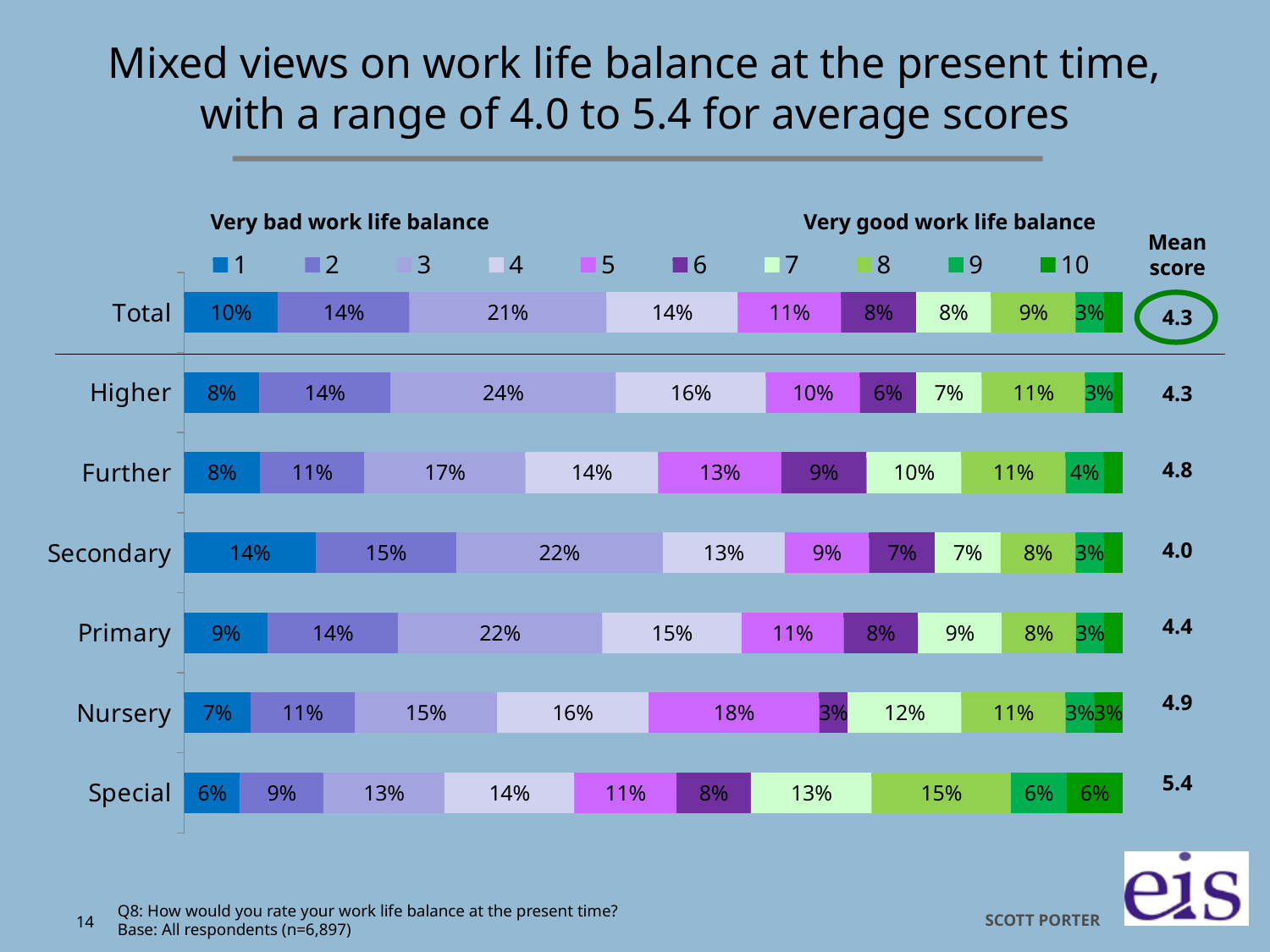
What is the mean score shown for the Special sector? 5.4 What kind of chart is shown on the slide? Stacked bar chart Which sector has the lowest percentage giving a rating of 1? Special What percentage of Special respondents gave a rating of 8? 15% What is the difference in percentage points between Nursery and Secondary for a rating of 5? 9 percentage points How many rating categories does the legend list? 10 What percentage of Total respondents gave a rating of 3? 21% What percentage of Nursery respondents gave a rating of 5? 18% What percentage of Further respondents gave a rating of 6? 9% How many sectors (including Total) are shown in the chart? 7 Which is larger: the percentage giving a rating of 8 in Special or in Higher? Special Which sector has the highest percentage giving a rating of 1? Secondary